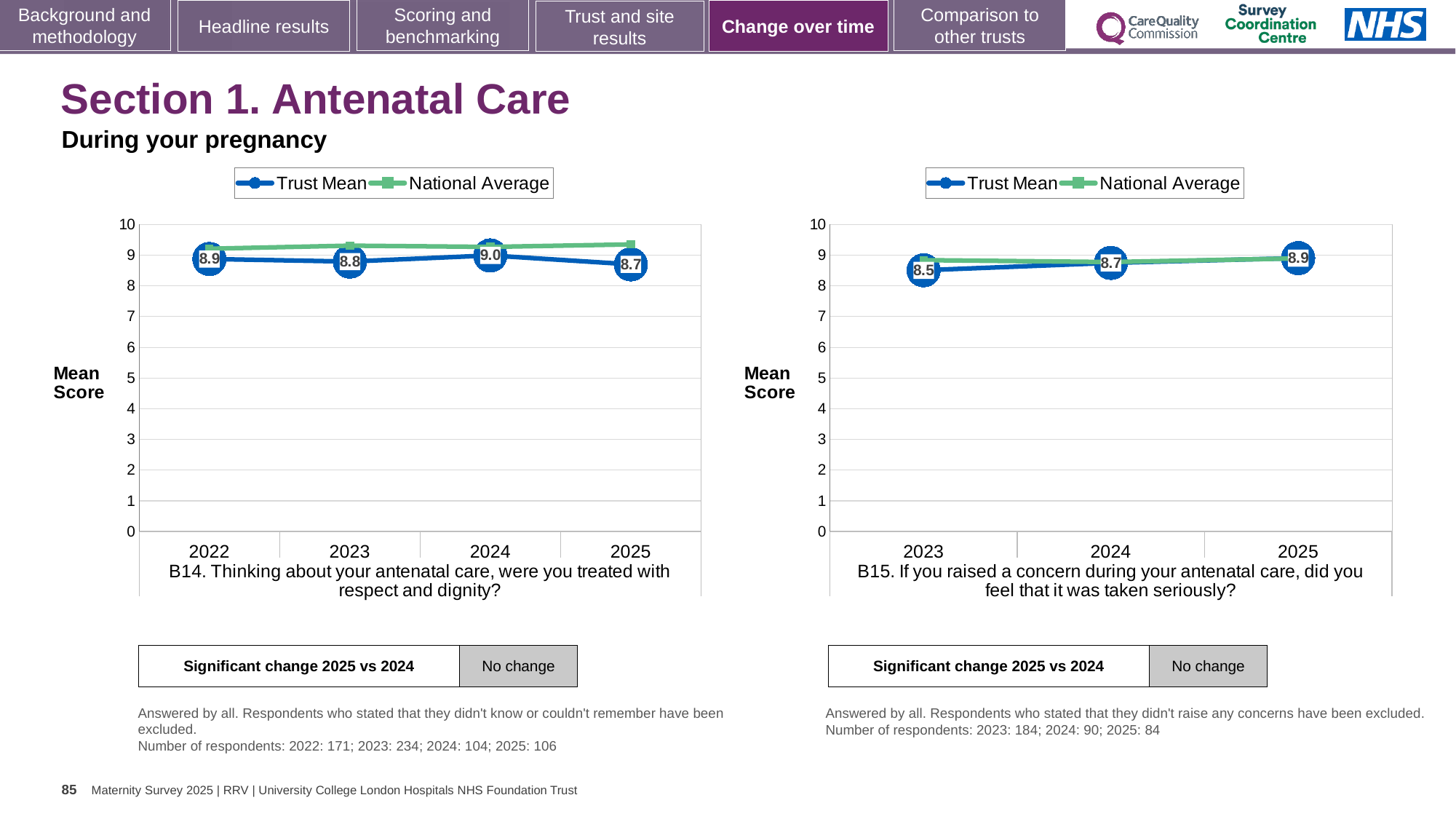
In the B15 chart (right), what is the Trust Mean for 2023? 8.5 In the B15 chart (right), is the Trust Mean higher in 2023 or 2024? 2024 In the B15 chart (right), which year has the highest Trust Mean? 2025 What type of chart is the B14 chart (left)? line chart In the B14 chart (left), what is the Trust Mean for 2024? 9.0 In the B14 chart (left), what is the difference between the Trust Mean for 2024 and 2025? 0.3 How many years are shown on the x axis of the B14 chart (left)? 4 In the B14 chart (left), what is the Trust Mean for 2025? 8.7 How many series does the legend of the B15 chart (right) list? 2 In the B14 chart (left), which year has the lowest Trust Mean? 2025 In the B15 chart (right), does the Trust Mean rise or fall from 2023 to 2025? rise In the B15 chart (right), what is the difference between the Trust Mean for 2025 and 2023? 0.4